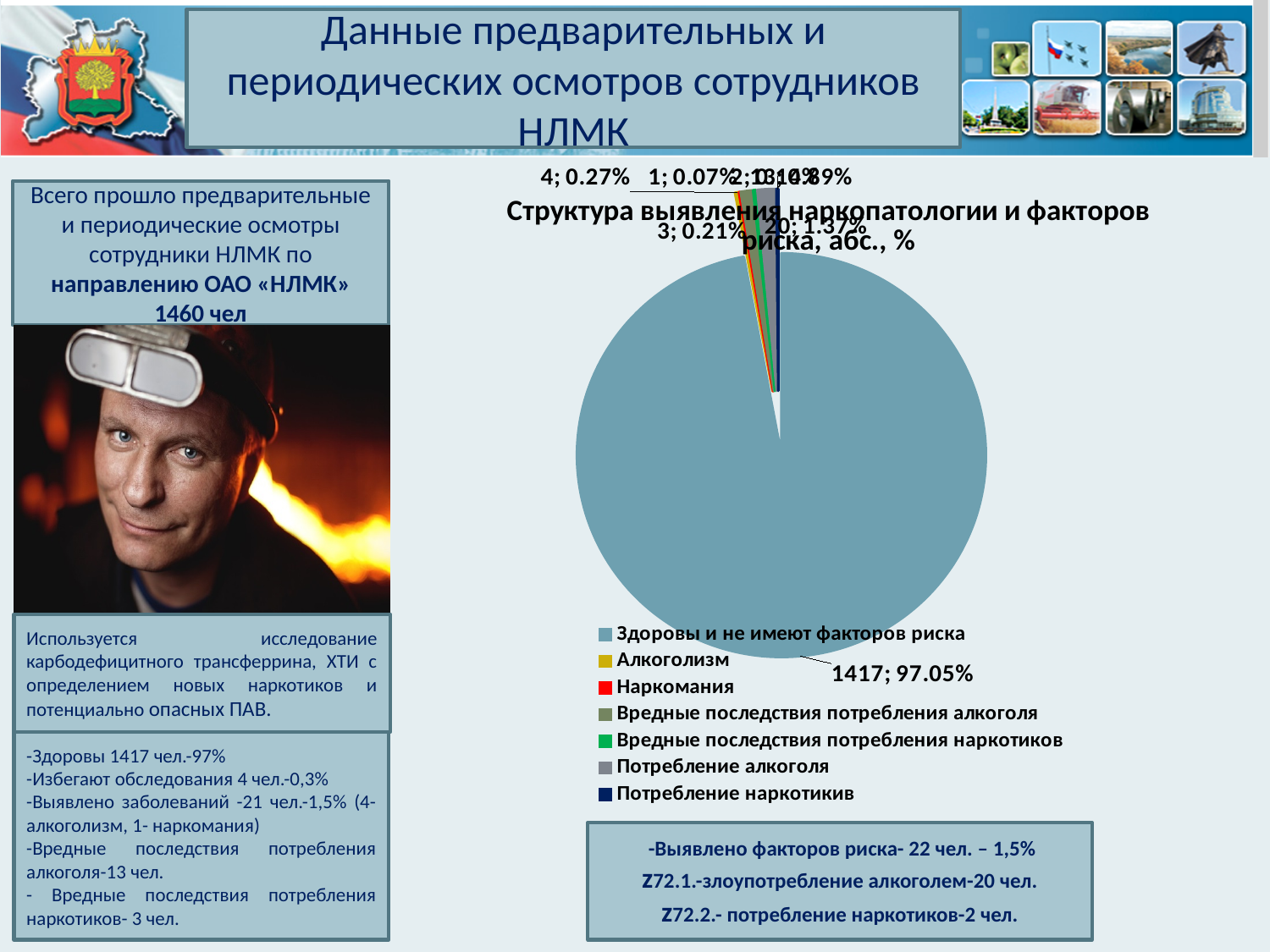
How many categories does the chart legend list? 7 What is the title of the chart? Структура выявления наркопатологии и факторов риска, абс., % What is the data label for the 'Здоровы и не имеют факторов риска' slice? 1417; 97.05% Which category has the smallest slice of the pie? Наркомания What is the data label for the 'Потребление алкоголя' slice? 20; 1.37% Which is larger, the value for 'Потребление алкоголя' or the value for 'Алкоголизм'? Потребление алкоголя Which category has the largest slice of the pie? Здоровы и не имеют факторов риска What type of chart is shown on the slide? pie chart What is the difference between the absolute values for 'Здоровы и не имеют факторов риска' and 'Потребление алкоголя'? 1397 What is the data label for the 'Наркомания' slice? 1; 0.07% What is the data label for the 'Алкоголизм' slice? 4; 0.27% What share of the pie does 'Здоровы и не имеют факторов риска' take? 97.05%